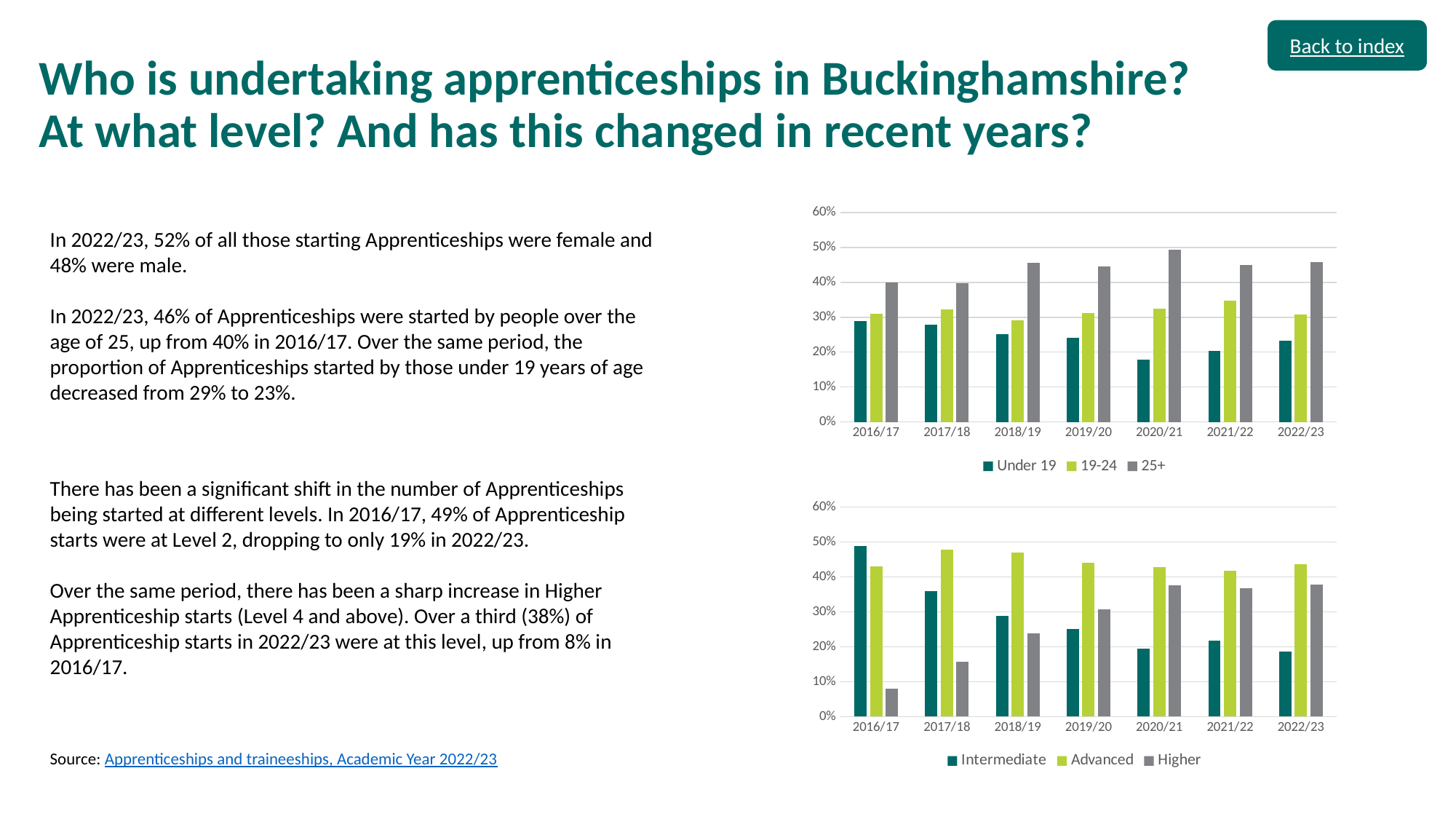
How many series does the legend of the top chart list? 3 In the bottom chart, which is larger in 2022/23: Intermediate or Higher? Higher What kind of chart is the top chart on the slide? bar chart In the top chart, which age group has the lowest value in 2020/21? Under 19 In the top chart, which age group has the highest value in 2022/23? 25+ In the bottom chart, which level has the lowest value in 2016/17? Higher In the bottom chart, does the Higher series rise or fall from 2016/17 to 2022/23? rise In the top chart, does the Under 19 series rise or fall from 2016/17 to 2022/23? fall How many academic years are shown on the x axis of the bottom chart? 7 In the bottom chart, is the value for Higher in 2016/17 greater or less than 10%? less What are the legend entries of the bottom chart? Intermediate, Advanced, Higher In the top chart, is the value for Under 19 in 2020/21 greater or less than 20%? less